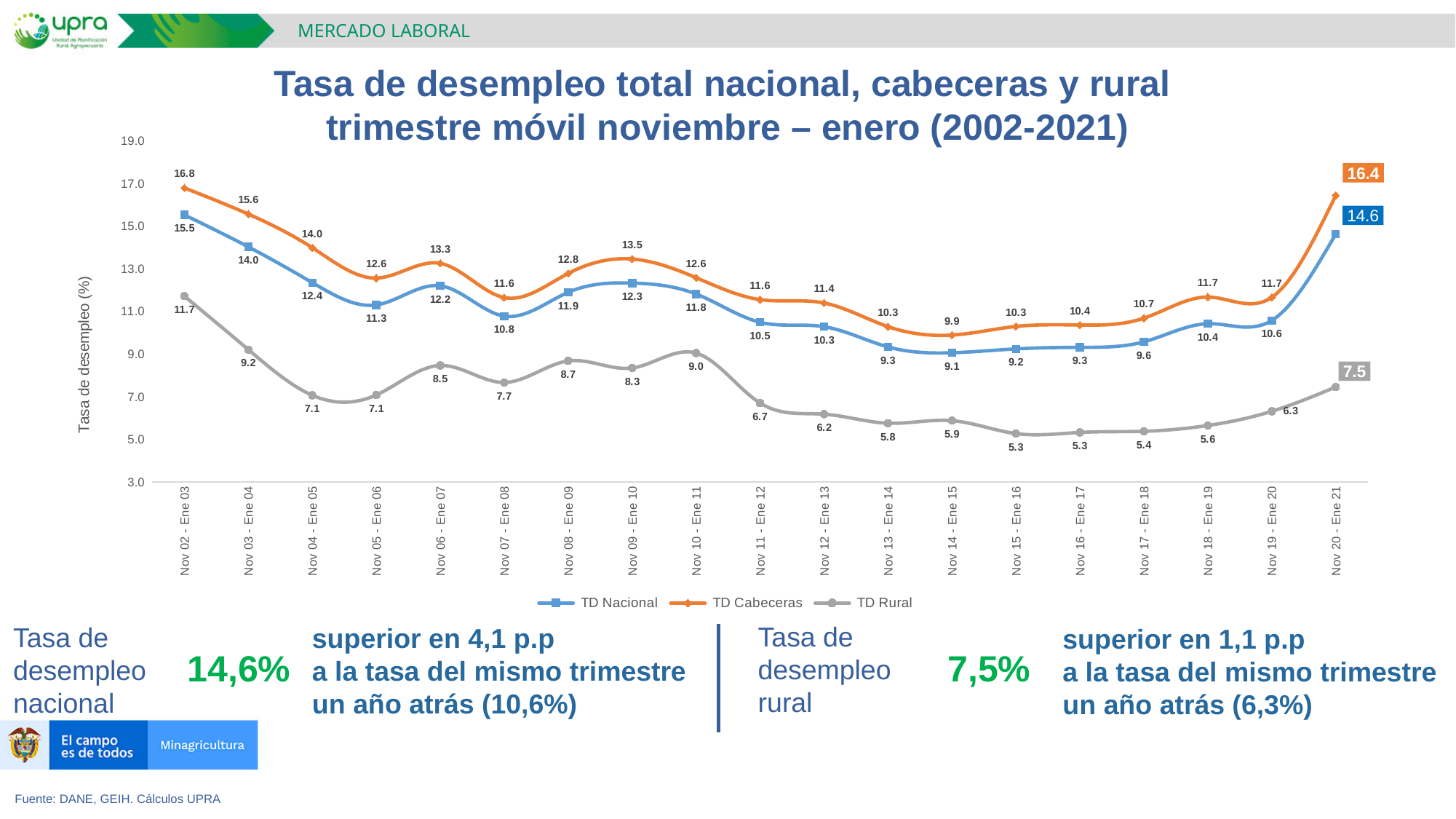
In which period does TD Cabeceras reach its highest value? Nov 02 - Ene 03 What is the value of TD Rural for Nov 20 - Ene 21? 7.5 How many periods are plotted on the x axis? 19 How many series does the legend list? 3 Which is larger for TD Rural: the value in Nov 02 - Ene 03 or in Nov 20 - Ene 21? Nov 02 - Ene 03 Does TD Rural rise or fall from Nov 02 - Ene 03 to Nov 05 - Ene 06? Fall What is the value of TD Cabeceras for Nov 02 - Ene 03? 16.8 In which period does TD Nacional reach its lowest value? Nov 14 - Ene 15 What is the difference between TD Cabeceras and TD Nacional in Nov 20 - Ene 21? 1.8 By how much did TD Nacional increase from Nov 19 - Ene 20 to Nov 20 - Ene 21? 4.0 What kind of chart is shown on the slide? Line chart What is the value of TD Nacional for Nov 20 - Ene 21? 14.6